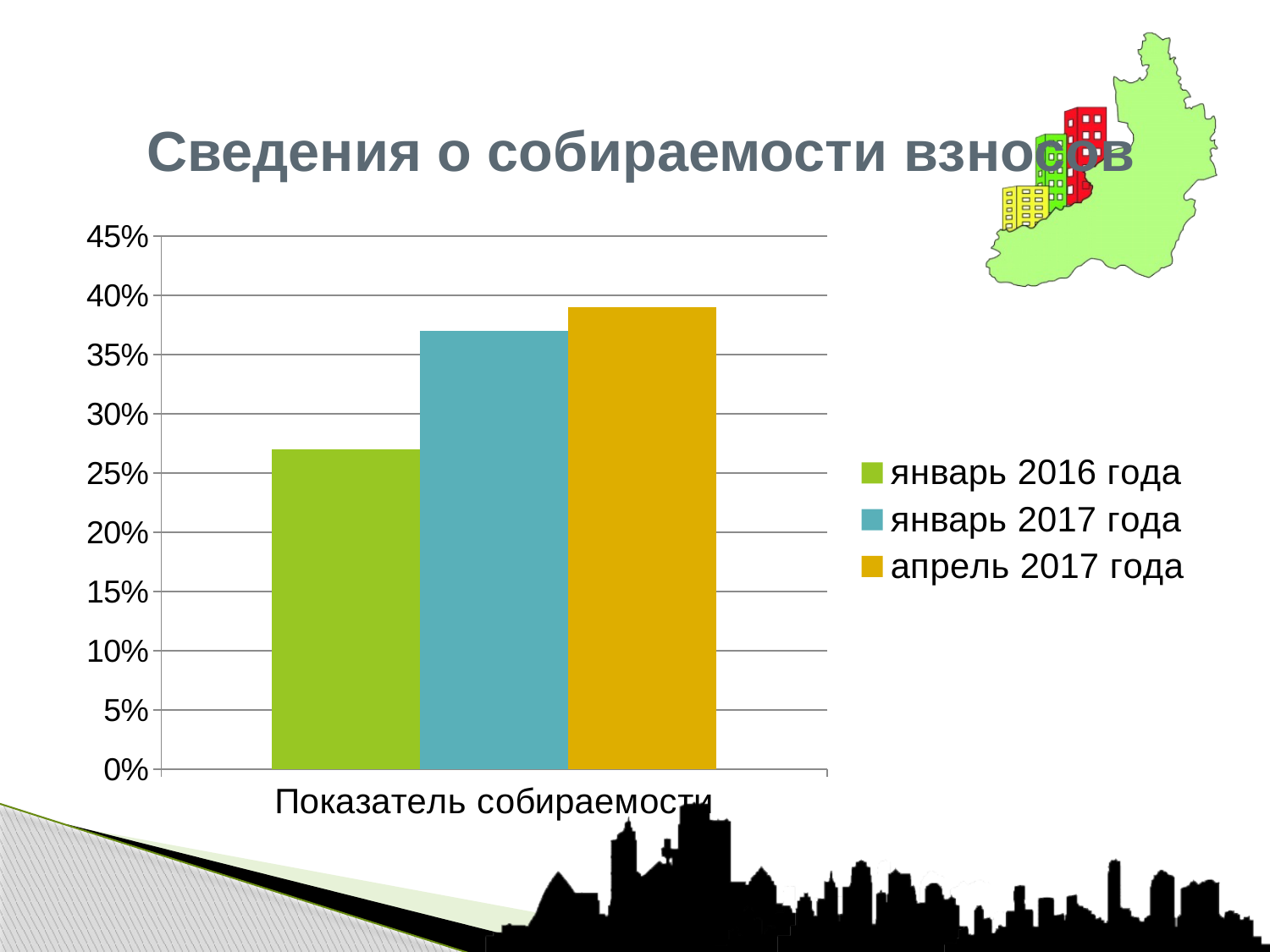
Which is larger, the value for январь 2016 года or the value for январь 2017 года? январь 2017 года How many categories are shown on the x axis? 1 Which is larger, the value for январь 2016 года or the value for апрель 2017 года? апрель 2017 года Is the value for январь 2017 года greater or less than 35%? greater What is the title of the slide above the chart? Сведения о собираемости взносов How many series does the legend list? 3 Which series has the highest value? апрель 2017 года Is the value for январь 2016 года greater or less than 30%? less What kind of chart is shown on the slide? Bar chart Is the value for апрель 2017 года greater or less than 40%? less Which series has the lowest value? январь 2016 года